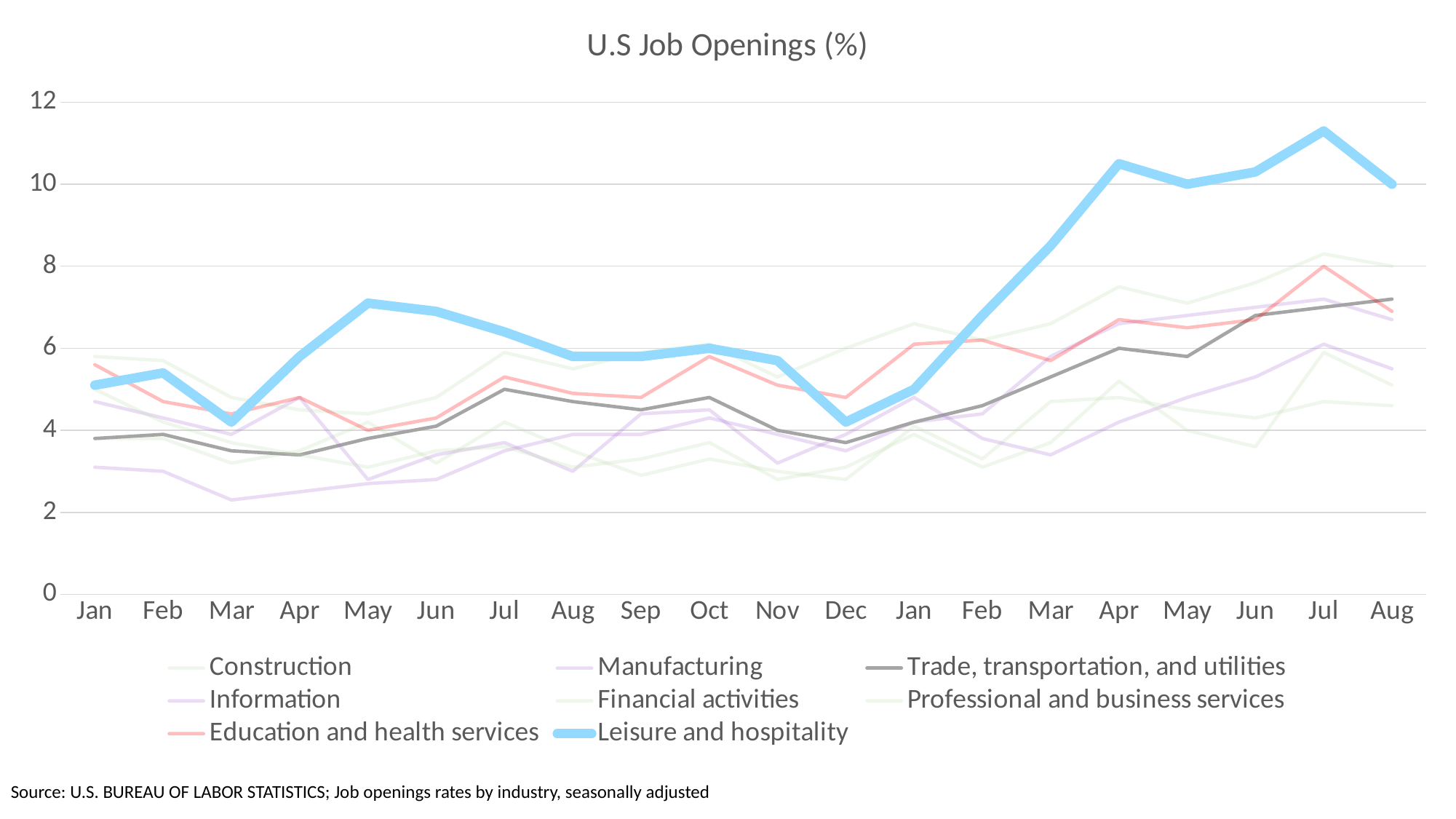
In which month does Leisure and hospitality reach its highest value? Jul (second year) What is the title of the chart? U.S Job Openings (%) Which series is drawn with the thick blue line? Leisure and hospitality Is the value for Leisure and hospitality in the second Jul greater or less than 10? greater Is the value for Trade, transportation, and utilities in the first Jan greater or less than 4? less How many series does the legend list? 8 What kind of chart is shown on the slide? line chart Does the Leisure and hospitality line rise or fall from Dec to the second Apr? rise Which series reaches the highest value on the chart? Leisure and hospitality Is the value for Leisure and hospitality in Dec greater or less than 6? less How many months are shown along the x axis? 20 In the second Apr, which is larger: Leisure and hospitality or Trade, transportation, and utilities? Leisure and hospitality